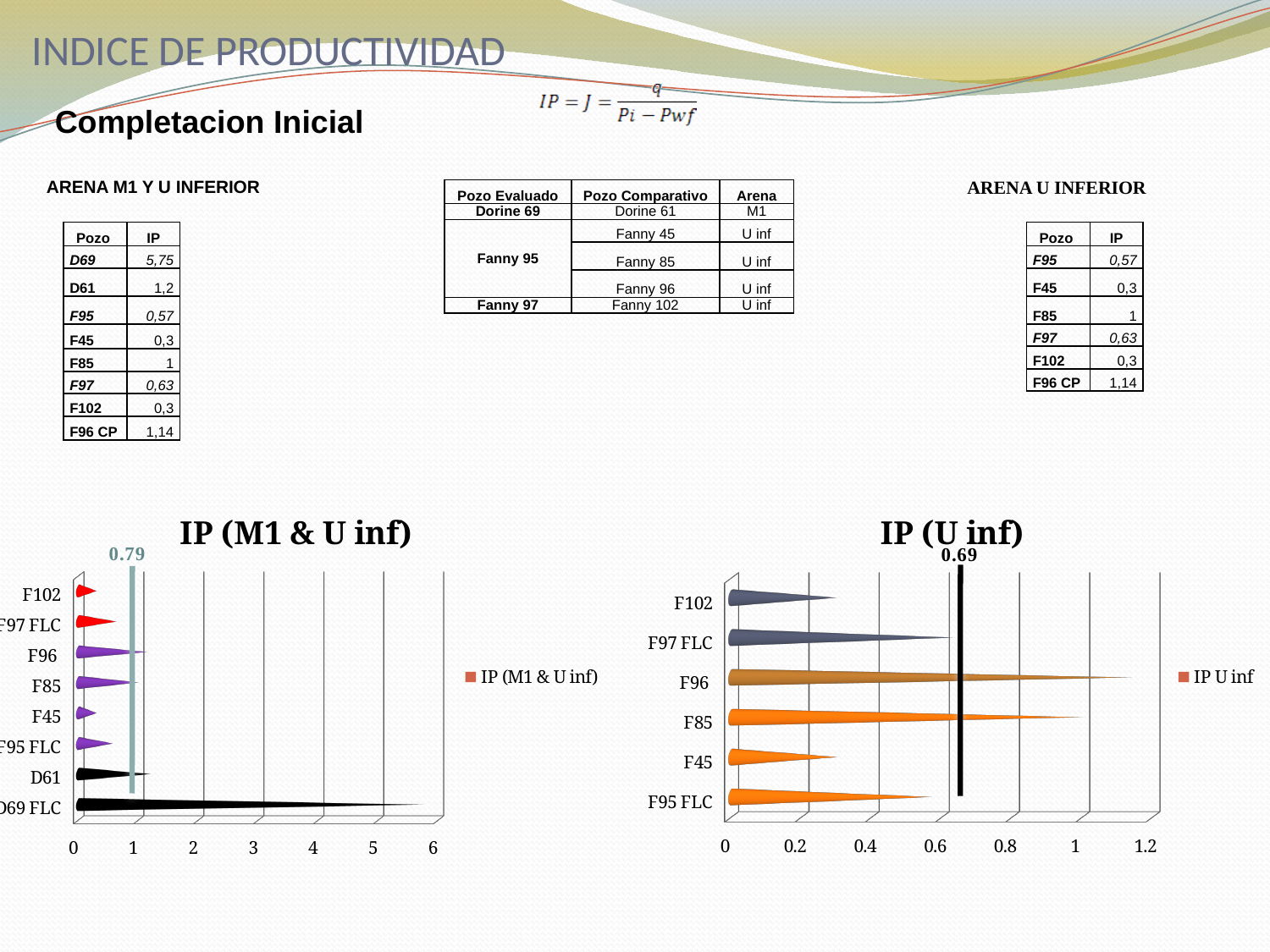
In the "IP (M1 & U inf)" chart on the left, is the value for D69 FLC greater or less than 5? greater How many series does the legend of the "IP (U inf)" chart on the right list? 1 In the "IP (M1 & U inf)" chart on the left, is the value for F102 greater or less than 1? less In the "IP (U inf)" chart on the right, which is larger, the value for F97 FLC or the value for F45? F97 FLC What kind of chart is the "IP (M1 & U inf)" chart on the left? bar chart In the "IP (U inf)" chart on the right, is the value for F96 greater or less than 1? greater How many categories are plotted in the "IP (U inf)" chart on the right? 6 In the "IP (M1 & U inf)" chart on the left, which category has the highest value? D69 FLC In the "IP (M1 & U inf)" chart on the left, which is larger, the value for D69 FLC or the value for D61? D69 FLC How many categories are plotted in the "IP (M1 & U inf)" chart on the left? 8 What value is labelled on the vertical reference line in the "IP (M1 & U inf)" chart on the left? 0.79